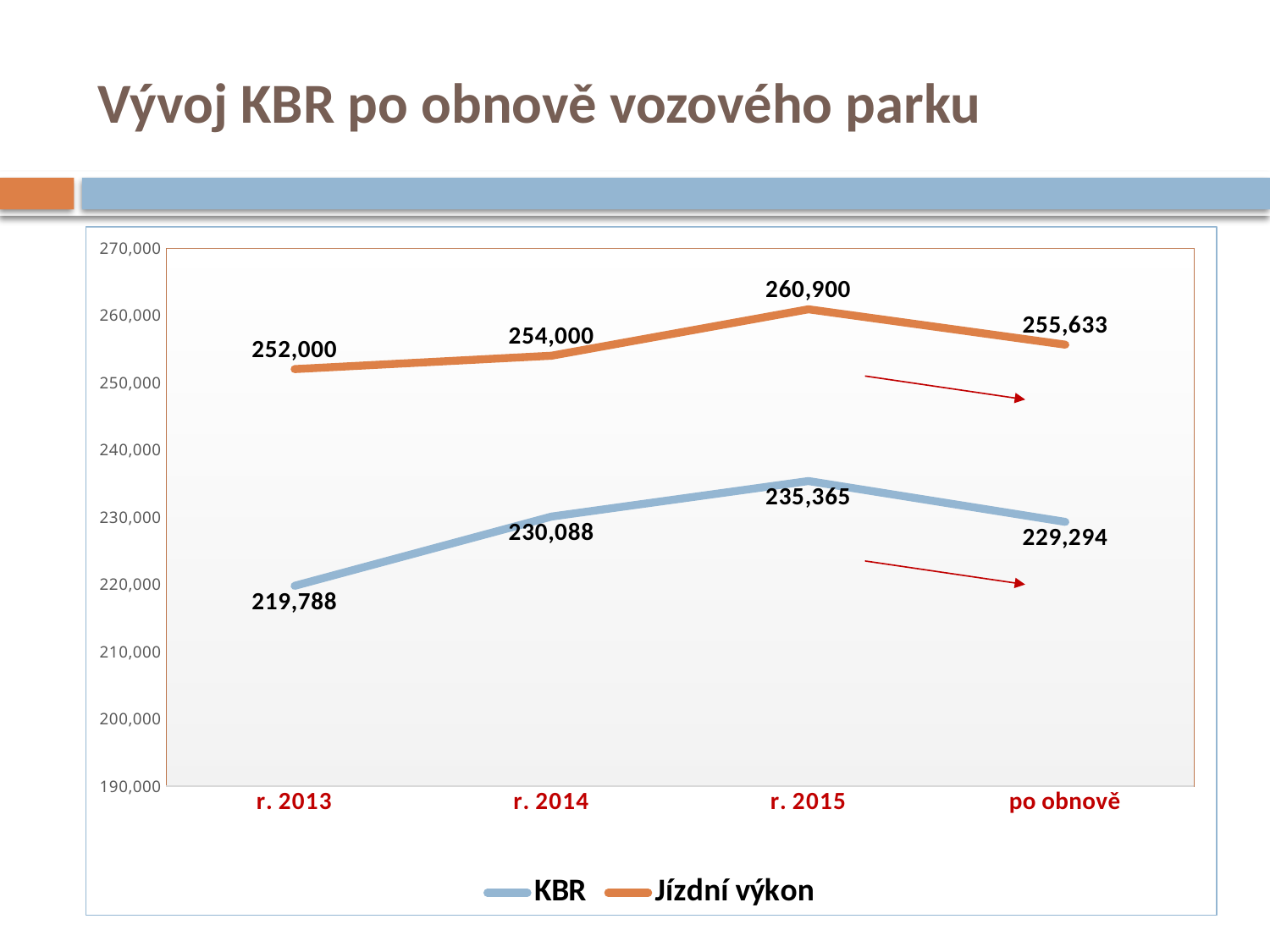
What is the difference between the Jízdní výkon values for r. 2015 and po obnově? 5,267 What kind of chart is shown on the slide? line chart What is the Jízdní výkon value for r. 2015? 260,900 In which category does KBR reach its highest value? r. 2015 In which category is Jízdní výkon lowest? r. 2013 How many series does the legend list? 2 What is the KBR value for po obnově? 229,294 What is the KBR value for r. 2013? 219,788 What is the Jízdní výkon value for r. 2014? 254,000 How many categories are shown on the x axis? 4 Which is larger, the KBR value for r. 2014 or for po obnově? r. 2014 Does the KBR series rise or fall from r. 2013 to r. 2015? rise